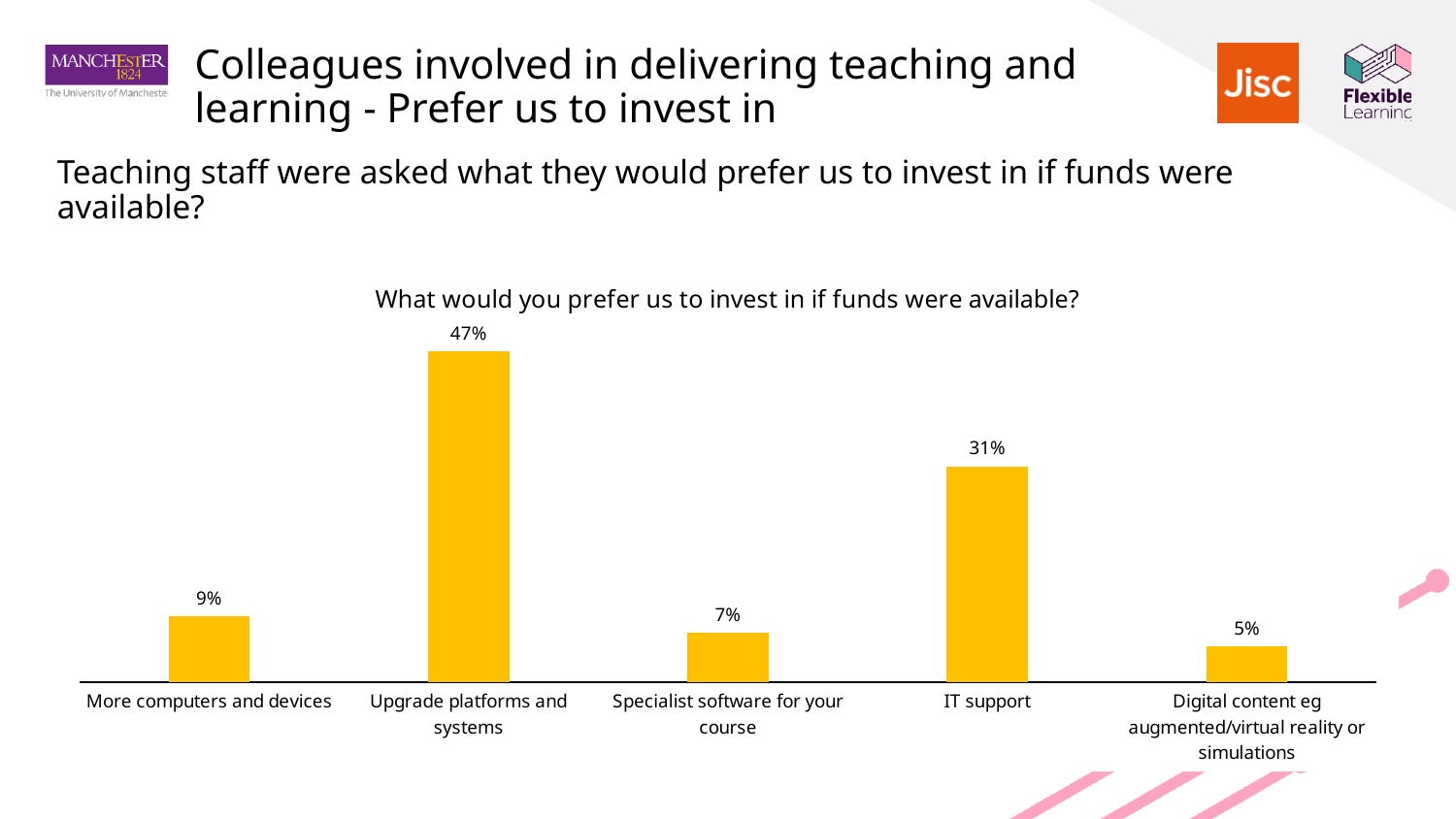
What type of chart is shown on the slide? Bar chart How many investment options are shown on the chart? 5 What is the value shown for IT support? 31% Which investment option has the highest percentage? Upgrade platforms and systems What percentage of teaching staff would prefer investment in upgrading platforms and systems? 47% What percentage is shown for more computers and devices? 9% Which has a higher value: more computers and devices or specialist software for your course? More computers and devices What is the title of the chart? What would you prefer us to invest in if funds were available? What is the difference in percentage points between upgrade platforms and systems and IT support? 16 What is the value for digital content eg augmented/virtual reality or simulations? 5% Which investment option has the lowest percentage? Digital content eg augmented/virtual reality or simulations What is the difference in percentage points between more computers and devices and specialist software for your course? 2